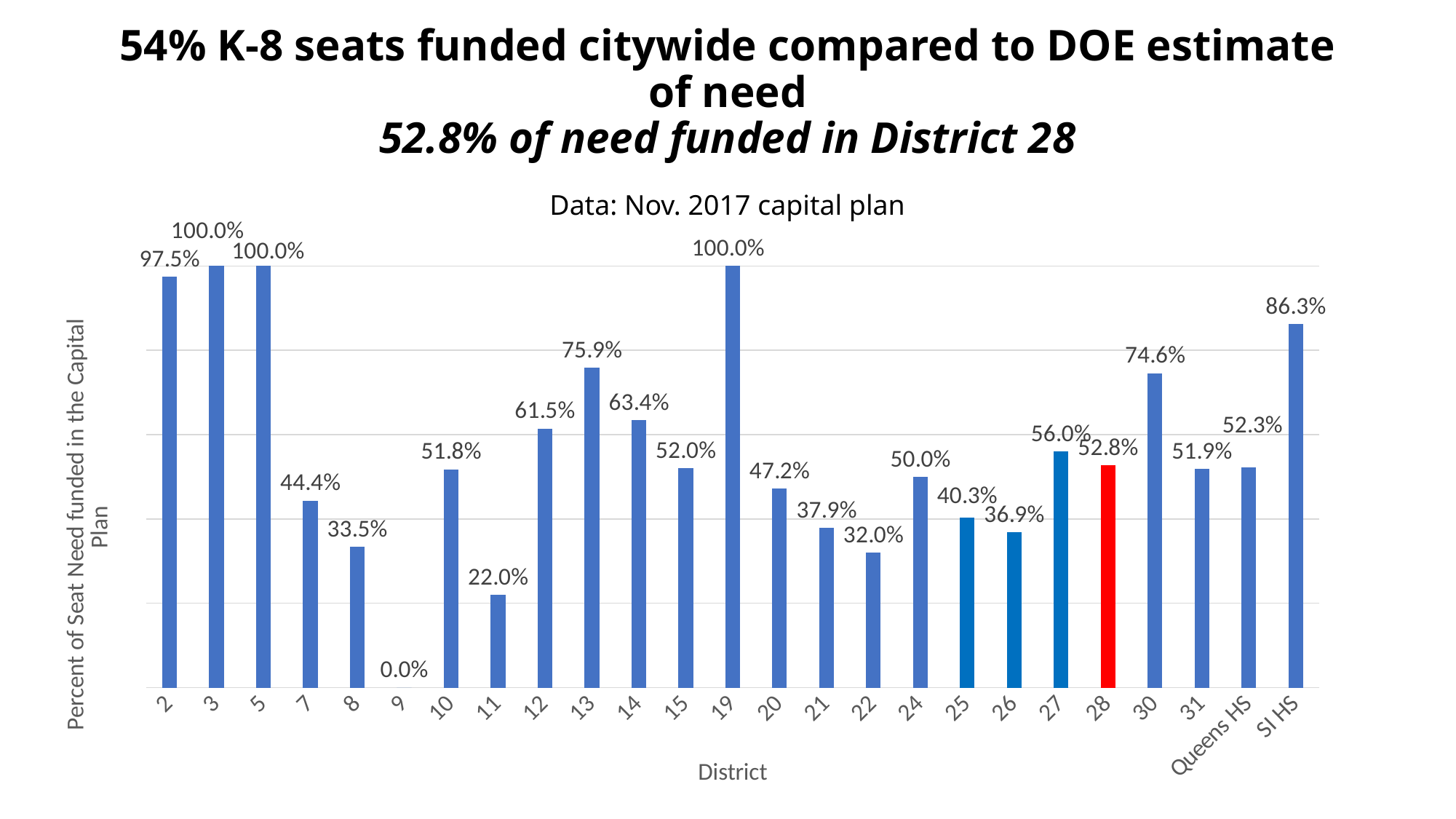
What is the difference between the values for District 27 and District 28? 3.2% Which is larger, the value for District 12 or the value for District 14? District 14 Which district has the lowest value? 9 Which district's bar is coloured red? 28 What is the value for District 28? 52.8% What is the difference between the values for SI HS and District 30? 11.7% What is the value for District 11? 22.0% What is the value for SI HS? 86.3% What is the value for District 13? 75.9% What kind of chart is shown on the slide? Bar chart Which is larger, the value for District 22 or the value for District 26? District 26 How many districts are shown on the x axis? 25